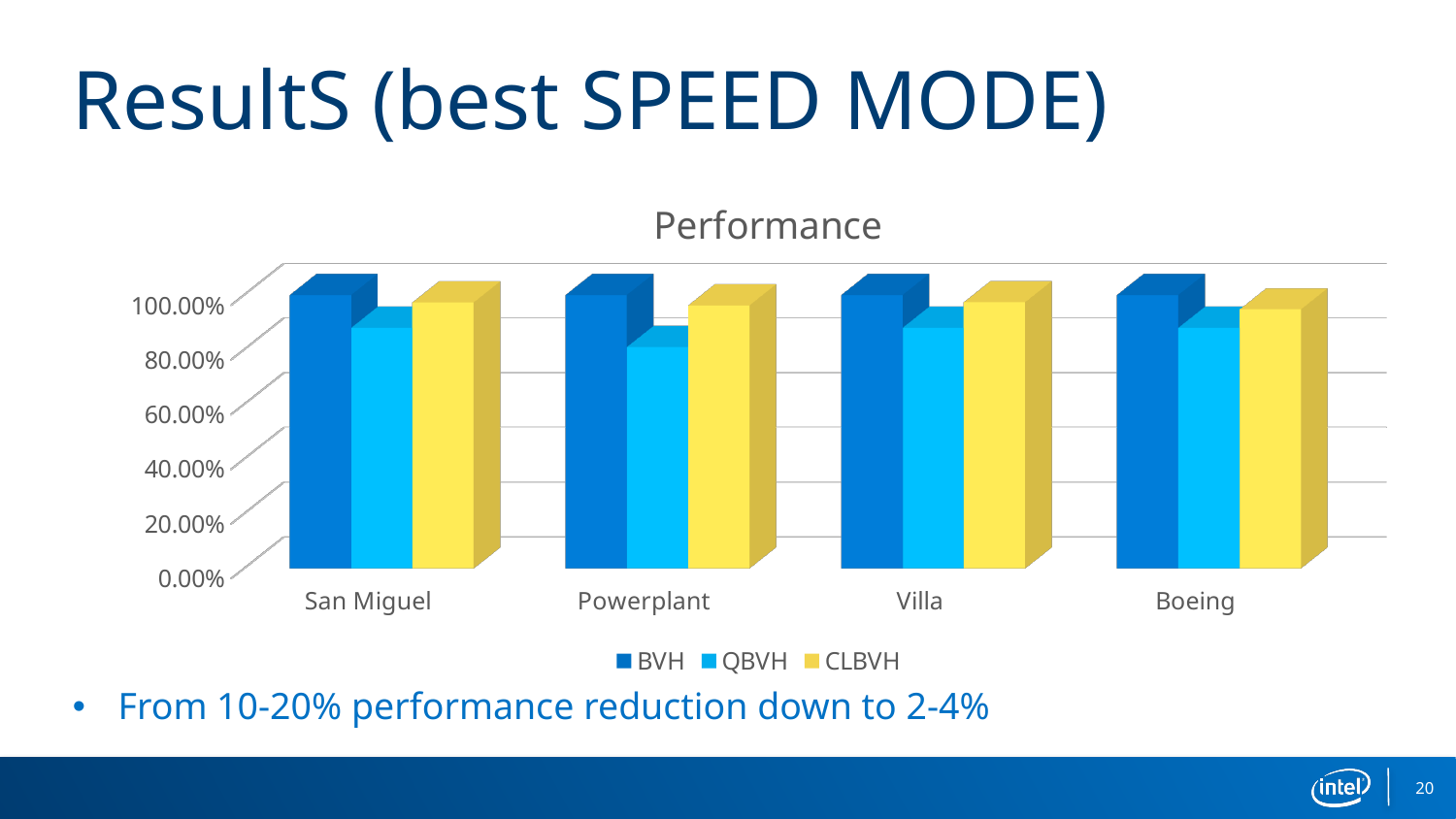
Which is larger for Villa, the BVH value or the QBVH value? BVH For which category is the QBVH value lowest? Powerplant How many series does the legend list? 3 Is the value for QBVH in Powerplant greater or less than 60.00%? greater How many categories are shown on the x axis of the chart? 4 Is the value for QBVH in Powerplant greater or less than 100.00%? less What kind of chart is shown on the slide? bar chart Which is larger for San Miguel, the QBVH value or the CLBVH value? CLBVH Which series has the highest value for Powerplant? BVH What is the title of the chart? Performance Which series has the lowest value for Powerplant? QBVH Which series are listed in the chart legend? BVH, QBVH, CLBVH